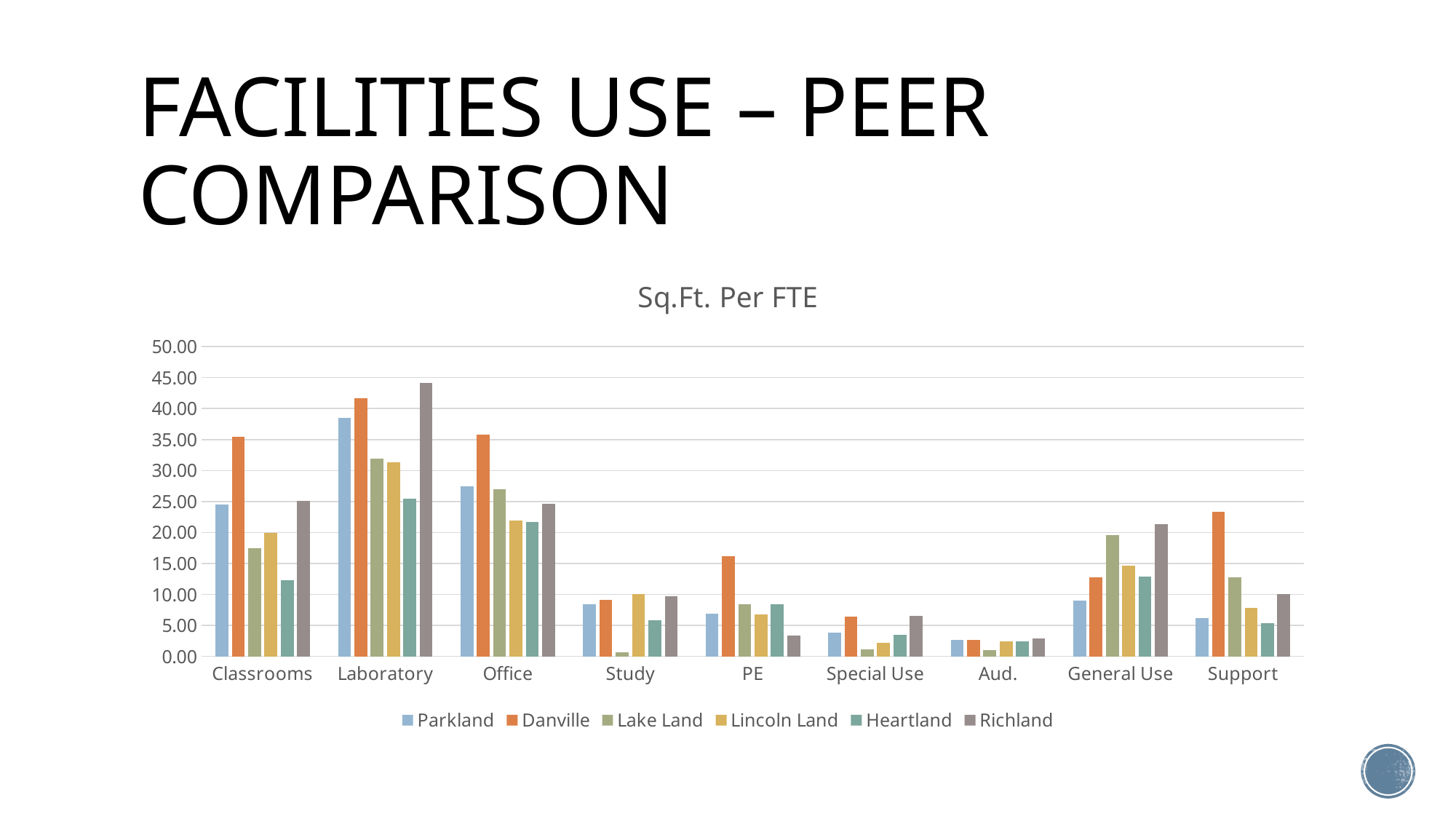
What is the title of the chart? Sq.Ft. Per FTE How many facility categories are shown along the x axis? 9 Is the value for Danville in PE greater or less than 15.00? greater For Office, which is larger: Parkland or Danville? Danville Is the value for Heartland in Classrooms greater or less than 15.00? less Which institution has the highest Sq.Ft. Per FTE for Support? Danville Which institution has the lowest Sq.Ft. Per FTE for Study? Lake Land Is the value for Danville in Classrooms greater or less than 30.00? greater Which institution has the highest Sq.Ft. Per FTE for Laboratory? Richland What kind of chart is shown on the slide? bar chart How many series does the legend list? 6 Which institution has the highest Sq.Ft. Per FTE for General Use? Richland